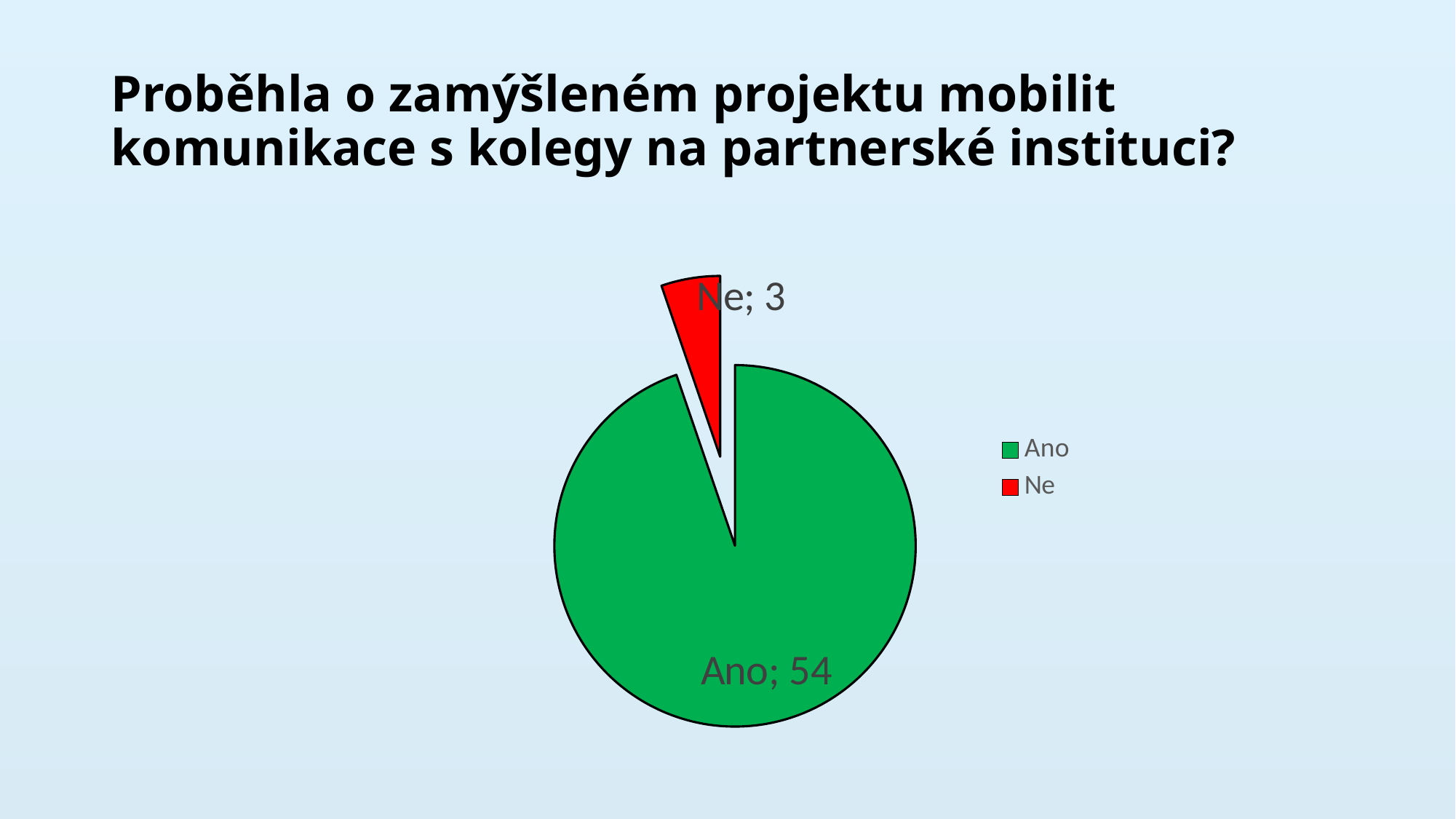
Which category has the largest slice? Ano How many entries does the legend list? 2 What is the difference between the values for Ano and Ne? 51 Which category has the smallest slice? Ne What is the total of all slices in the pie chart? 57 What kind of chart is shown on the slide? pie chart What is the value for Ano? 54 How many slices does the pie chart have? 2 Which is larger, Ano or Ne? Ano What is the value for Ne? 3 What colour is the Ne slice? red What colour is the Ano slice? green